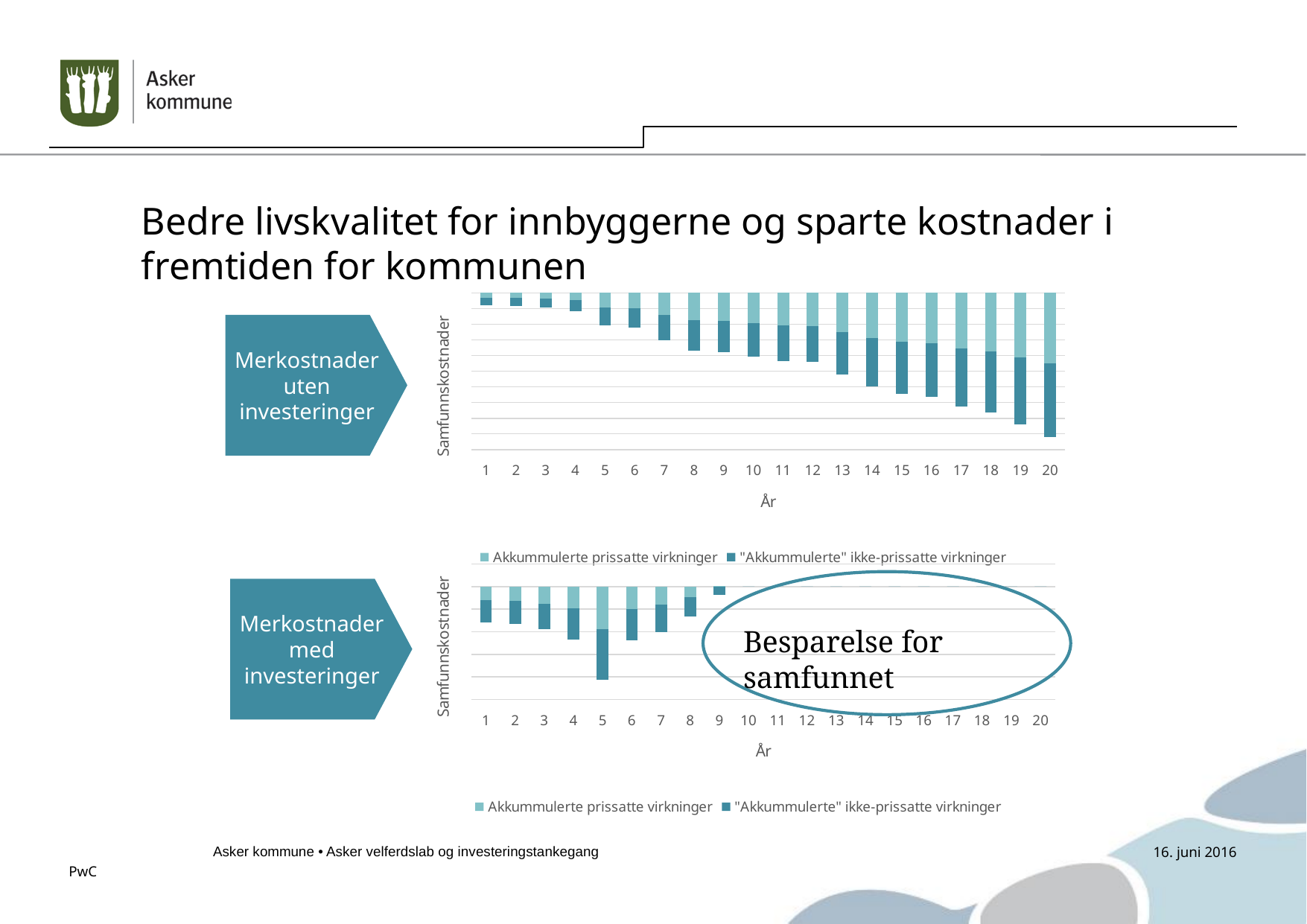
In the top chart (Merkostnader uten investeringer), how many years are shown on the x axis? 20 How many series does the legend of the top chart (Merkostnader uten investeringer) list? 2 What is the label of the x axis in the top chart (Merkostnader uten investeringer)? År In the bottom chart (Merkostnader med investeringer), how many years are shown on the x axis? 20 What is the label of the y axis in the bottom chart (Merkostnader med investeringer)? Samfunnskostnader What type of chart is the bottom chart (Merkostnader med investeringer)? Stacked bar chart In the top chart (Merkostnader uten investeringer), which year has the largest total bar? 20 What type of chart is the top chart (Merkostnader uten investeringer)? Stacked bar chart In the bottom chart (Merkostnader med investeringer), which is larger, the total bar for year 5 or the total bar for year 9? Year 5 In the bottom chart (Merkostnader med investeringer), which year has the largest total bar? 5 In the top chart (Merkostnader uten investeringer), which year has the smallest total bar? 1 In the top chart (Merkostnader uten investeringer), do the total bar lengths increase or decrease from year 1 to year 20? Increase